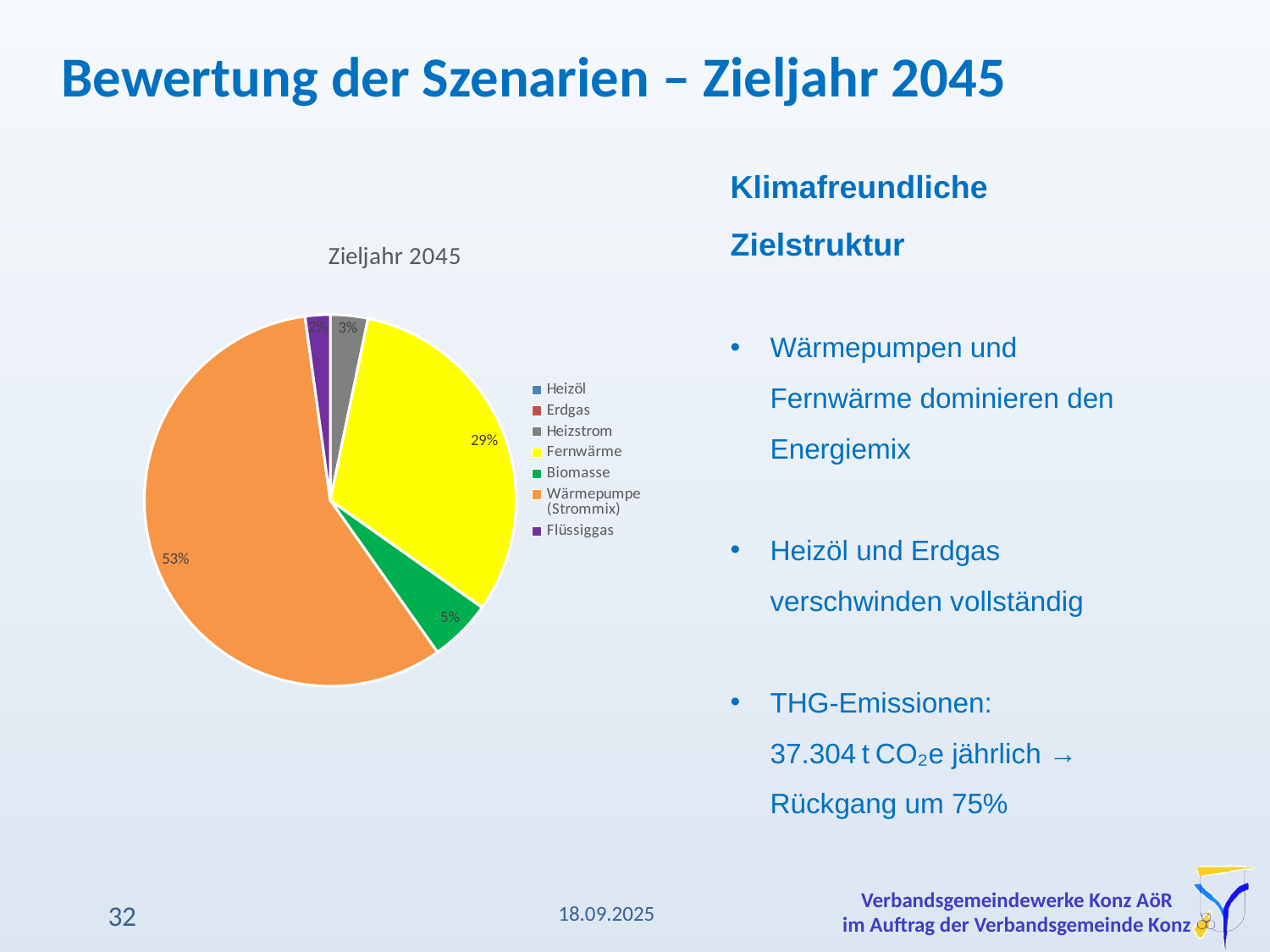
What colour is the Fernwärme slice in the pie chart? yellow What share of the pie does Wärmepumpe (Strommix) have? 53% Which category has the largest slice of the pie? Wärmepumpe (Strommix) Which slice is larger, Fernwärme or Biomasse? Fernwärme What share of the pie does Fernwärme have? 29% What is the title of the pie chart? Zieljahr 2045 What is the difference in percentage points between the Wärmepumpe (Strommix) slice and the Fernwärme slice? 24 percentage points How many entries does the legend of the pie chart list? 7 What is the combined share of Wärmepumpe (Strommix) and Fernwärme? 82% What share of the pie does Heizstrom have? 3% What kind of chart is shown on the slide? pie chart What share of the pie does Biomasse have? 5%